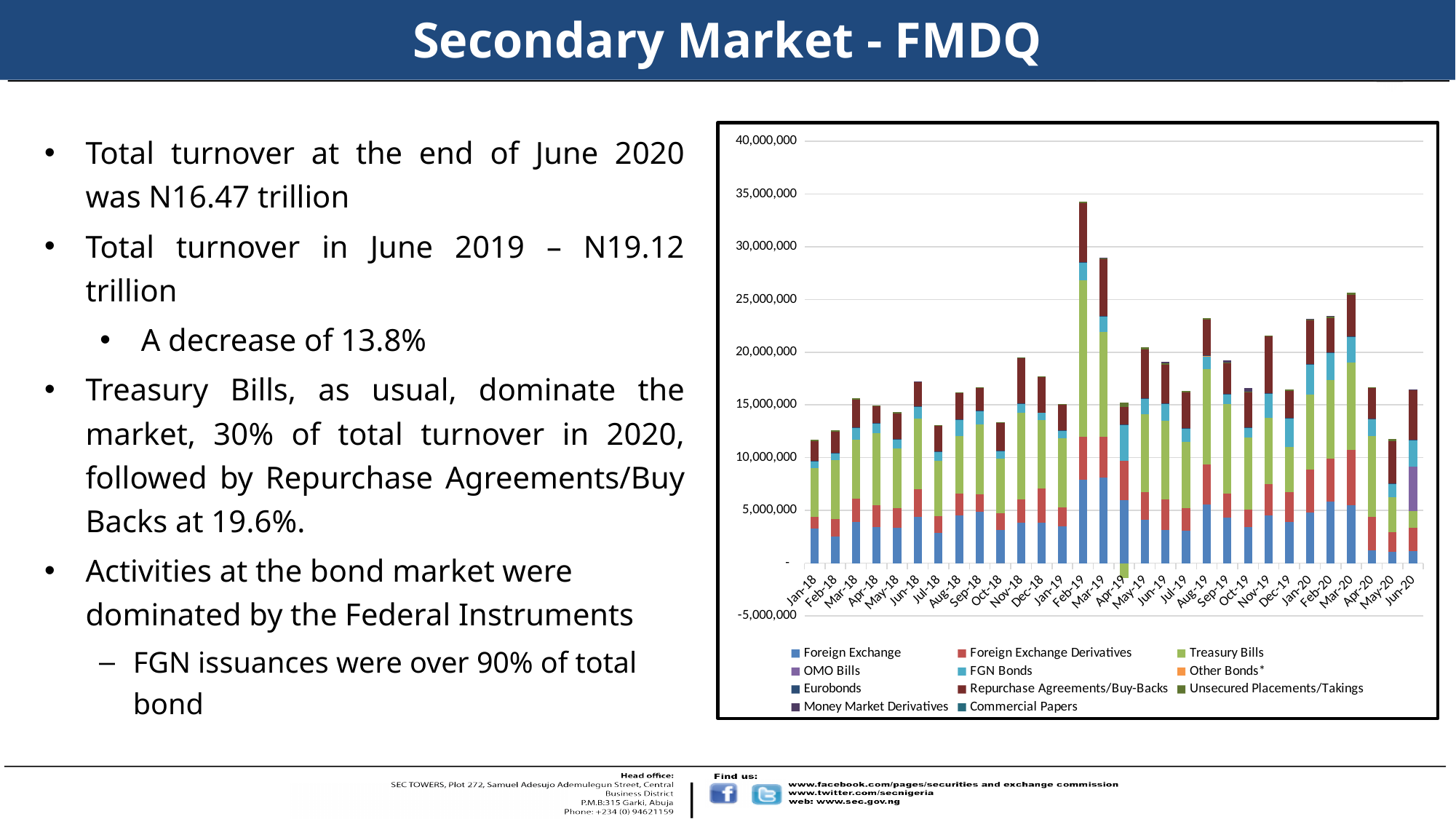
Which month has the highest total bar in the chart? Feb-19 How many series does the chart's legend list? 11 Is the total bar for Jan-18 greater or less than 15,000,000? less Which month has the larger total bar, Feb-19 or Mar-19? Feb-19 What is the highest value shown on the chart's y axis? 40,000,000 Which legend entry is shown in light green in the chart? Treasury Bills Is the total bar for Apr-19 greater or less than 20,000,000? less Which month has the larger total bar, Mar-20 or May-20? Mar-20 What kind of chart is shown on the slide? Stacked bar chart How many months are plotted along the x axis of the chart? 30 Is the total bar for Feb-19 greater or less than 30,000,000? greater